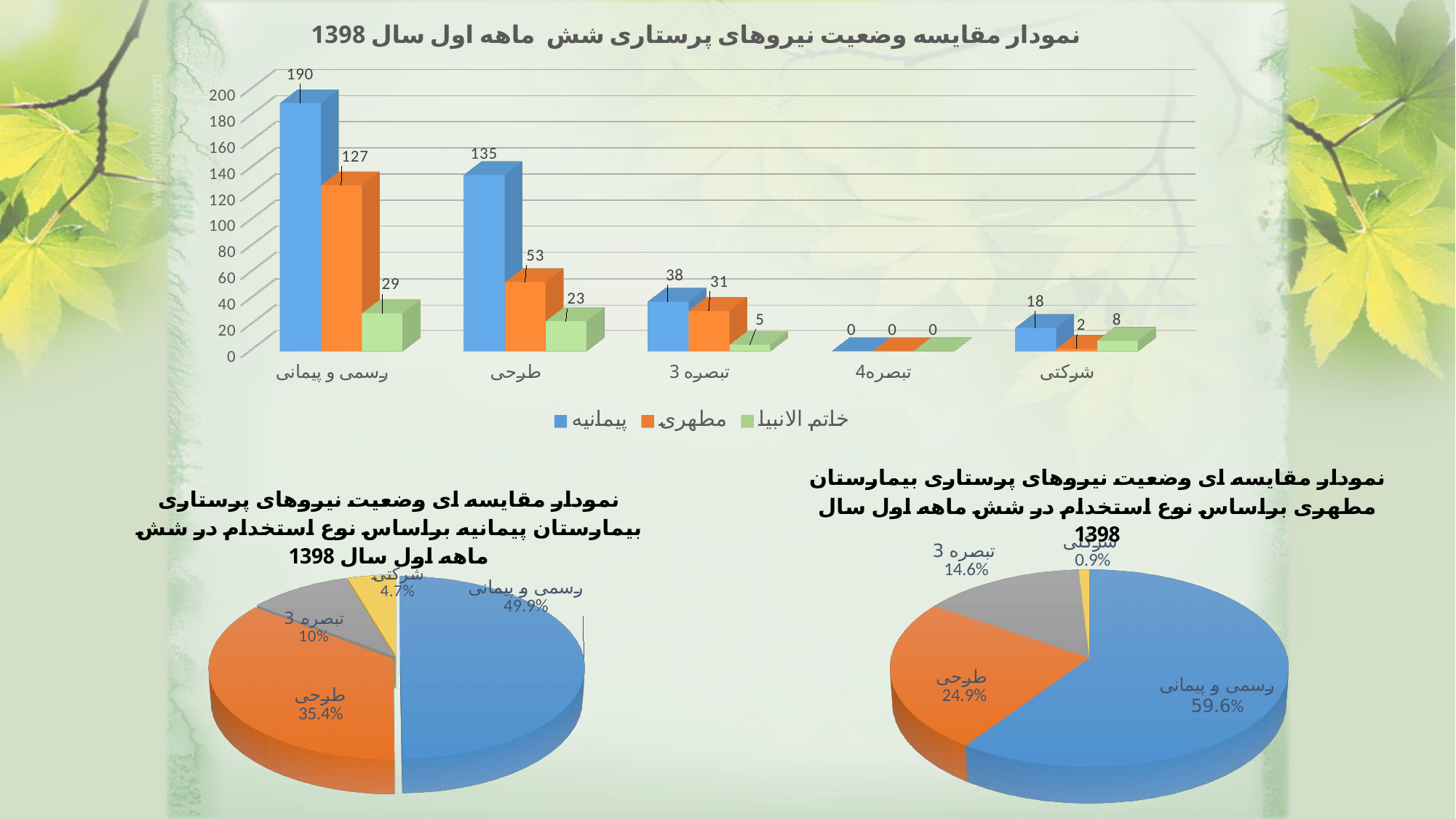
In the bottom-right pie chart (بیمارستان مطهری), which slice is the smallest? شرکتی In the top bar chart, which is larger in the تبصره 3 category: پیمانیه or مطهری? پیمانیه In the top bar chart, what is the value for مطهری in the طرحی category? 53 How many categories are shown on the x axis of the top bar chart? 5 In the top bar chart, which category has the highest value for the پیمانیه series? رسمی و پیمانی In the top bar chart, what is the value for پیمانیه in the رسمی و پیمانی category? 190 How many series does the legend of the top bar chart list? 3 In the top bar chart, what is the difference between the پیمانیه and مطهری values in the طرحی category? 82 In the top bar chart, what is the value for خاتم الانبیا in the شرکتی category? 8 In the bottom-right pie chart (بیمارستان مطهری), what share does رسمی و پیمانی have? 59.6% In the bottom-left pie chart (بیمارستان پیمانیه), what share does طرحی have? 35.4% What kind of chart is the chart at the top of the slide? bar chart